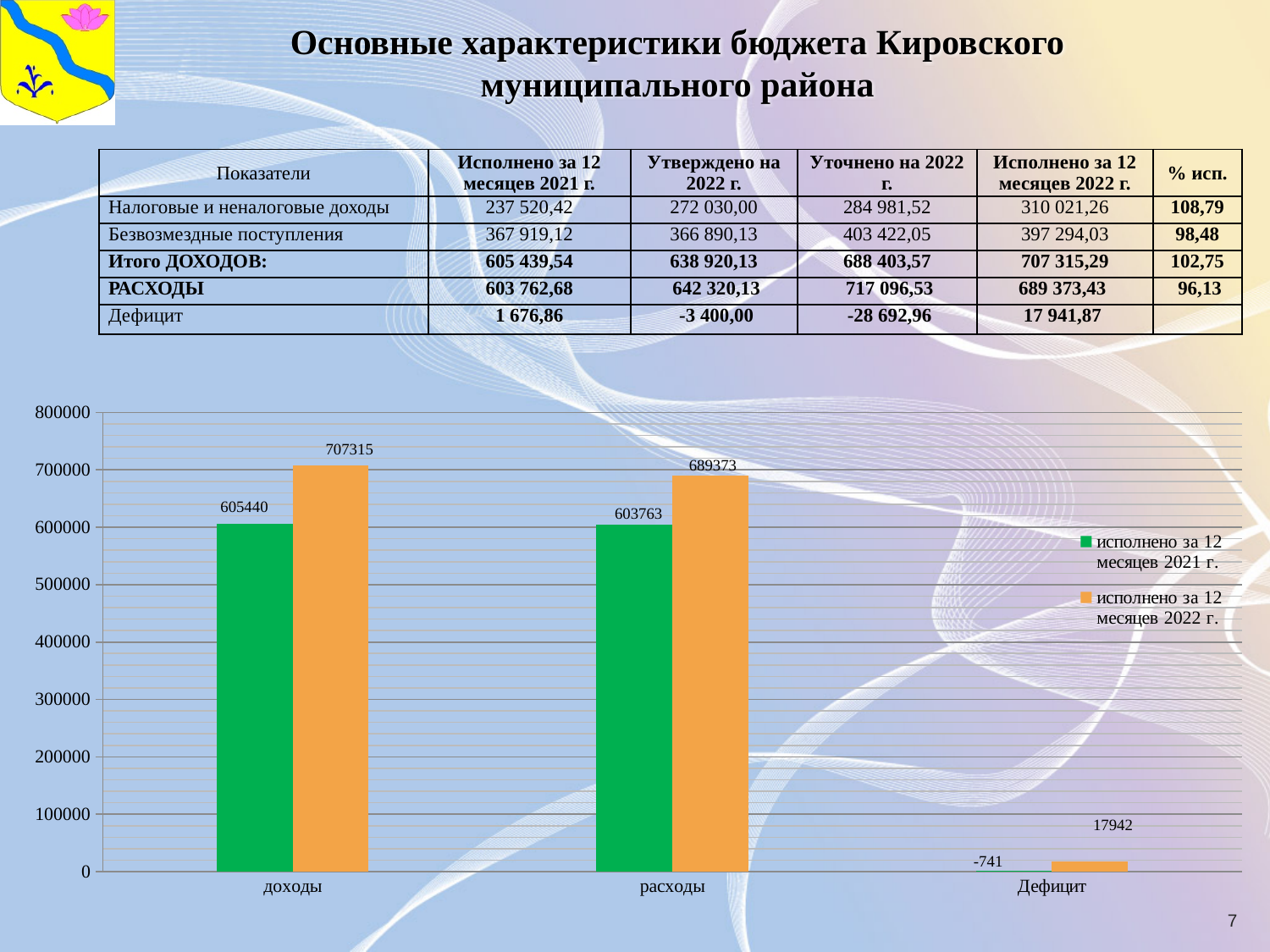
How many series does the chart legend list? 2 What is the value for доходы in the series исполнено за 12 месяцев 2022 г.? 707315 What is the value for доходы in the series исполнено за 12 месяцев 2021 г.? 605440 What type of chart is shown on the slide? bar chart Which category has the lowest value in the series исполнено за 12 месяцев 2021 г.? Дефицит What is the value for расходы in the series исполнено за 12 месяцев 2021 г.? 603763 Which colour represents the series исполнено за 12 месяцев 2021 г. in the chart? green What is the value for Дефицит in the series исполнено за 12 месяцев 2022 г.? 17942 Which category has the highest value in the series исполнено за 12 месяцев 2022 г.? доходы Which is larger: the value for расходы in 2022 or the value for доходы in 2022? доходы in 2022 How many categories are shown on the x axis of the chart? 3 What is the difference between the 2022 and 2021 values for доходы? 101875